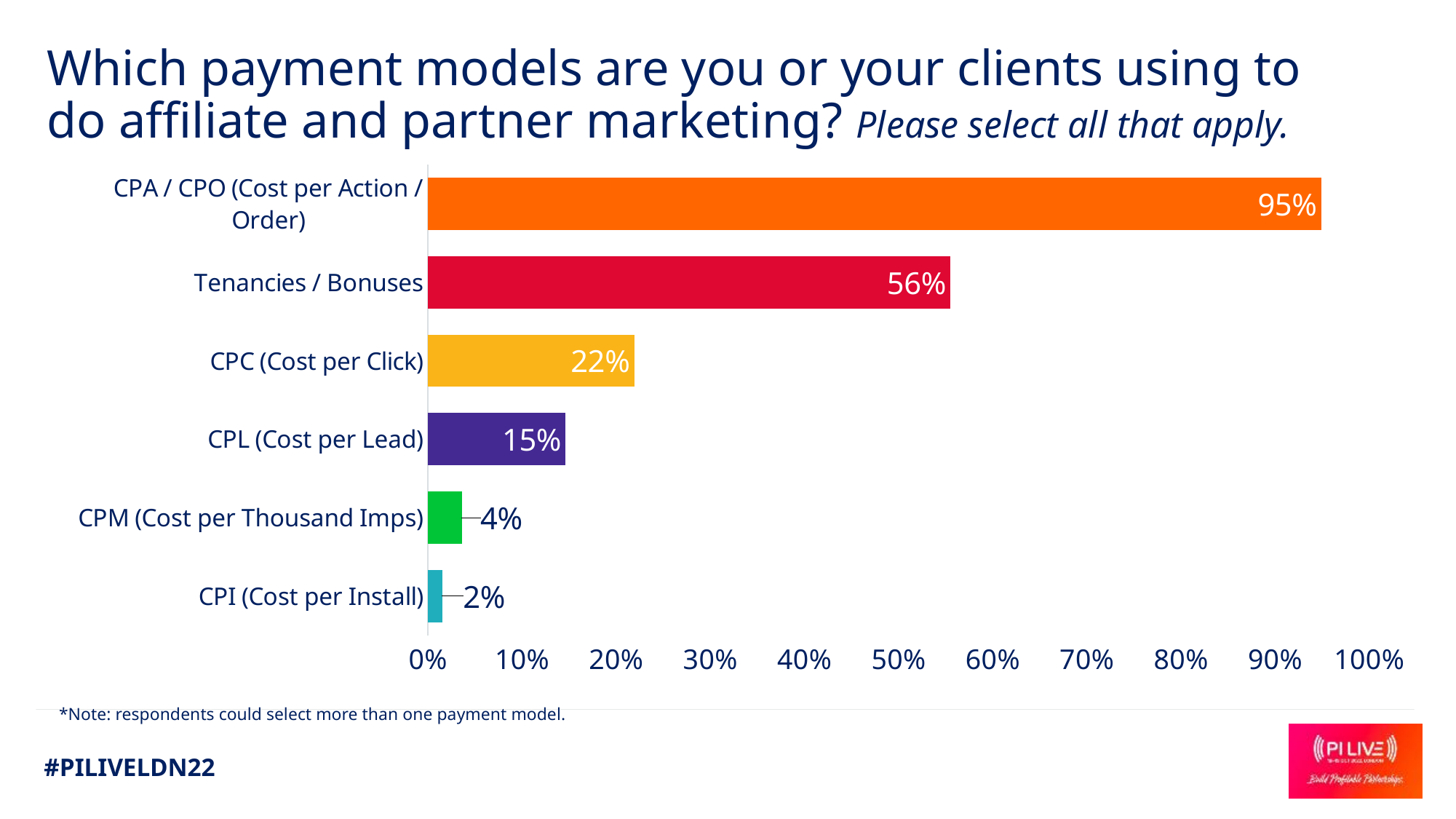
What colour is the bar for CPC (Cost per Click)? Yellow Which payment model has the lowest percentage? CPI (Cost per Install) What percentage of respondents use CPA / CPO (Cost per Action / Order)? 95% How many payment models are shown in the chart? 6 What is the value shown for Tenancies / Bonuses? 56% Is the value for Tenancies / Bonuses greater or less than 50%? greater Which is larger, the value for CPM (Cost per Thousand Imps) or CPI (Cost per Install)? CPM (Cost per Thousand Imps) What is the difference between the values for CPC (Cost per Click) and CPL (Cost per Lead)? 7% What is the difference between the values for CPA / CPO and Tenancies / Bonuses? 39% What type of chart is shown on the slide? Bar chart Which payment model has the highest percentage? CPA / CPO (Cost per Action / Order) What percentage is shown for CPL (Cost per Lead)? 15%